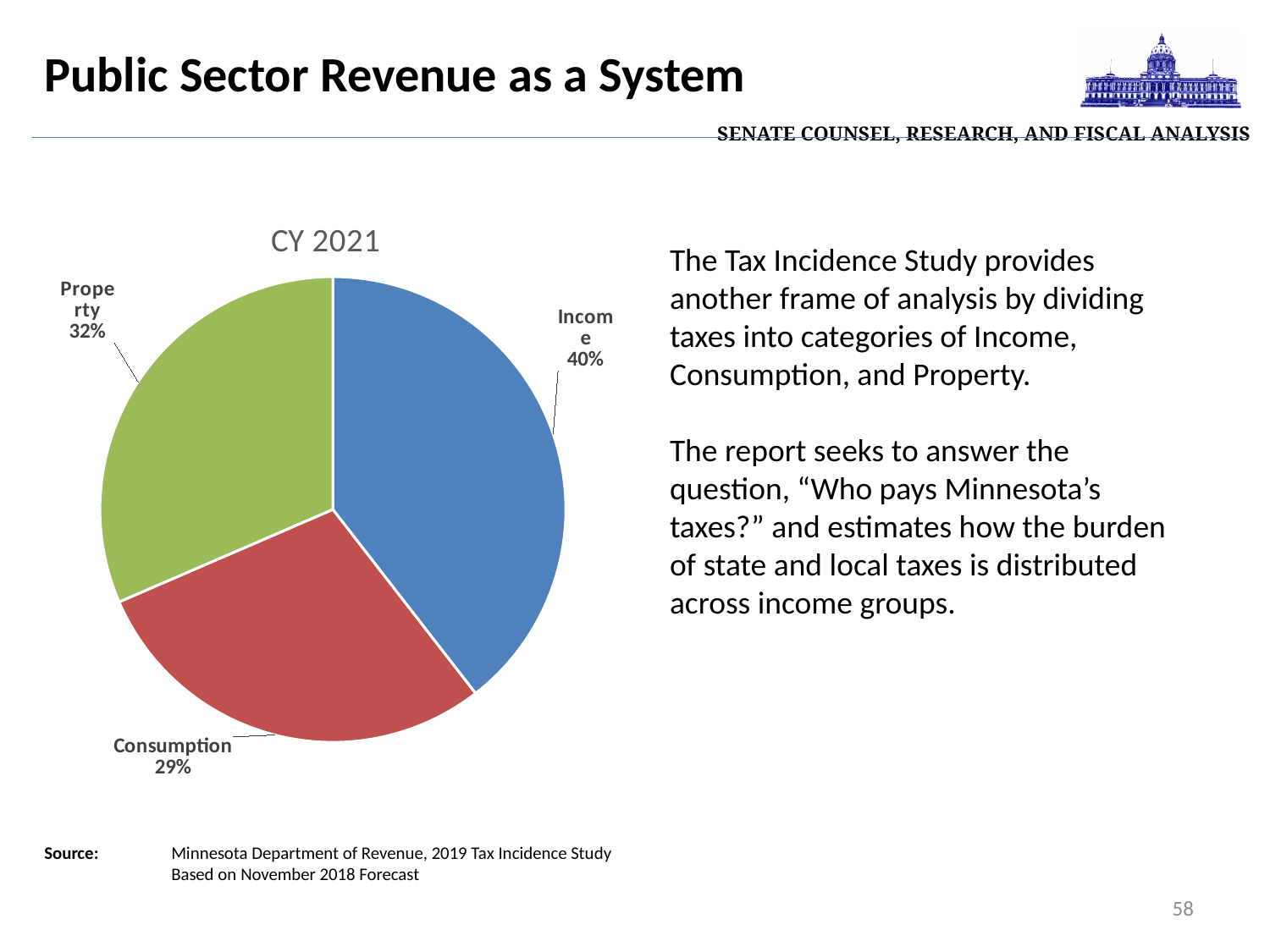
What is the title of the chart? CY 2021 What kind of chart is shown on the slide? Pie chart Which category has the smallest slice of the pie? Consumption What share of the pie does Consumption account for? 29% Which is larger, the Income slice or the Property slice? Income What is the difference in percentage points between the Property and Consumption slices? 3 What colour is the Consumption slice? Red What is the difference in percentage points between the Income and Consumption slices? 11 How many categories are shown in the pie chart? 3 Which category has the largest slice of the pie? Income What share of the pie does Income account for? 40% What share of the pie does Property account for? 32%